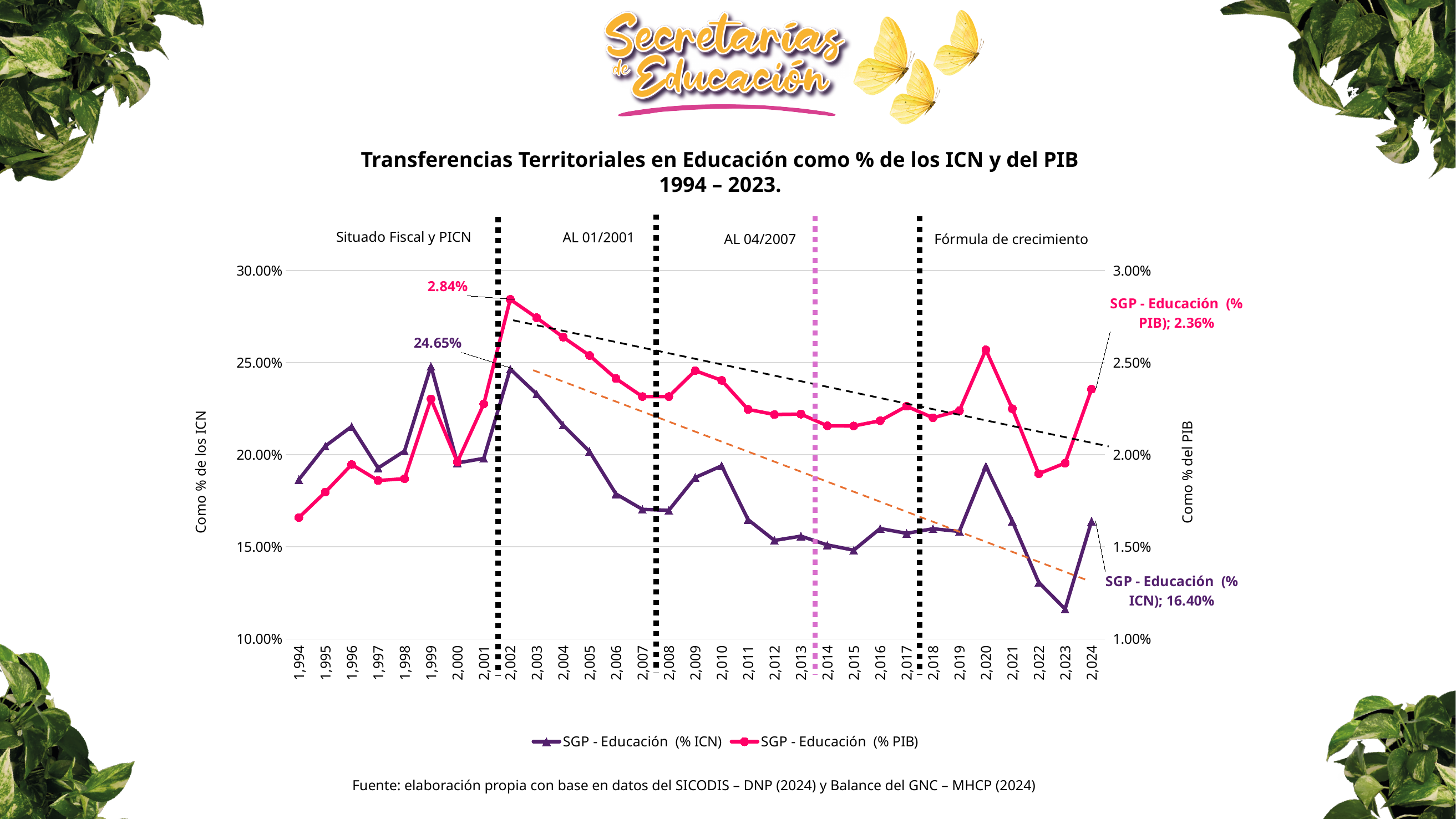
How many series does the legend list? 2 What is the value of SGP - Educación (% PIB) in 2002? 2.84% What is the value of SGP - Educación (% ICN) in 2024? 16.40% In which year does SGP - Educación (% ICN) reach its lowest value? 2023 In which year does SGP - Educación (% PIB) reach its highest value? 2002 What kind of chart is shown on the slide? Line chart What is the title of the left vertical axis? Como % de los ICN How many years are plotted along the x axis? 31 What is the value of SGP - Educación (% PIB) in 2024? 2.36% By how many percentage points did SGP - Educación (% ICN) fall from 2002 to 2024? 8.25 percentage points Is the value of SGP - Educación (% ICN) in 2023 greater or less than 15.00%? less What is the value of SGP - Educación (% ICN) in 2002? 24.65%